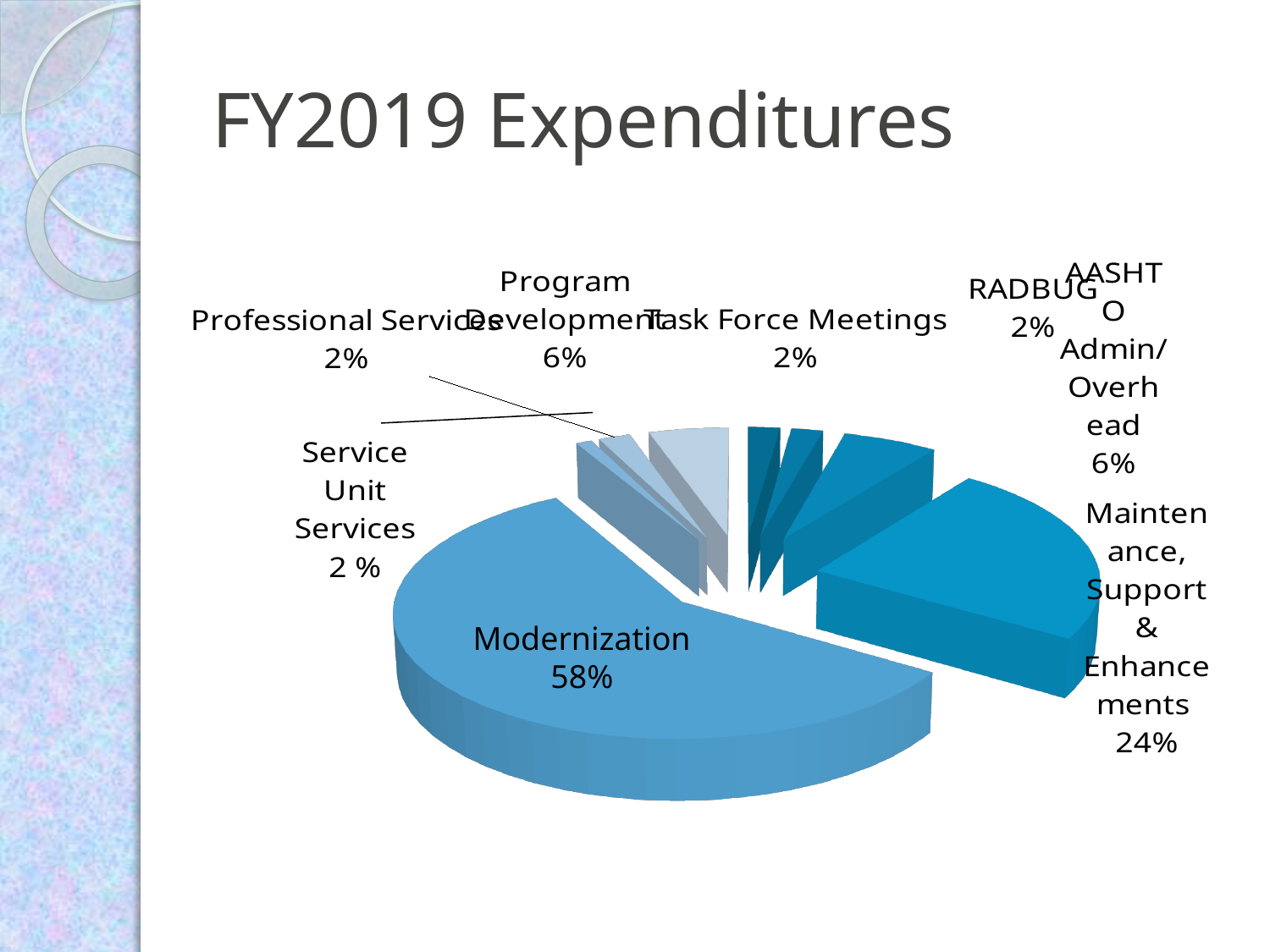
What share of FY2019 expenditures is Task Force Meetings? 2% What share of FY2019 expenditures is AASHTO Admin/Overhead? 6% Which category has the largest share of FY2019 expenditures? Modernization Which is larger, the share for Program Development or the share for Professional Services? Program Development What share of FY2019 expenditures is Program Development? 6% What kind of chart is shown on the slide? pie chart How many slices does the pie chart have? 8 What is the difference in percentage points between Modernization and Maintenance, Support & Enhancements? 34 What is the title of the slide containing the pie chart? FY2019 Expenditures What is the difference in percentage points between Maintenance, Support & Enhancements and AASHTO Admin/Overhead? 18